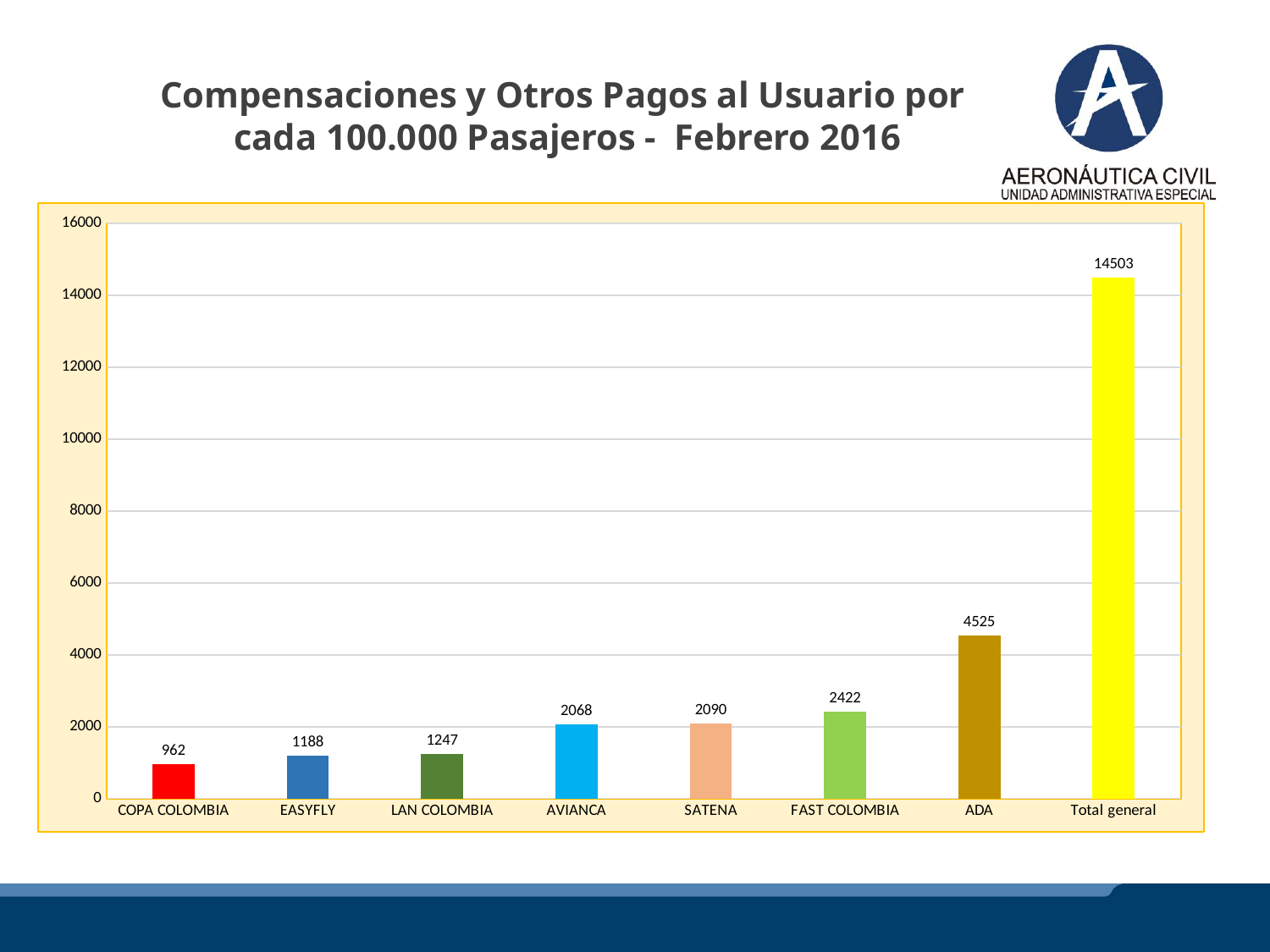
Is the value for FAST COLOMBIA greater or less than 2000? greater What is the difference between the values for LAN COLOMBIA and EASYFLY? 59 Which category has the lowest value? COPA COLOMBIA What is the value shown for Total general? 14503 What kind of chart is shown on the slide? Bar chart What is the value for COPA COLOMBIA? 962 What is the value for ADA? 4525 Which is larger, the value for AVIANCA or the value for LAN COLOMBIA? AVIANCA What is the value for SATENA? 2090 What is the difference between the values for ADA and FAST COLOMBIA? 2103 How many categories are shown on the x axis? 8 Excluding Total general, which airline has the highest value? ADA